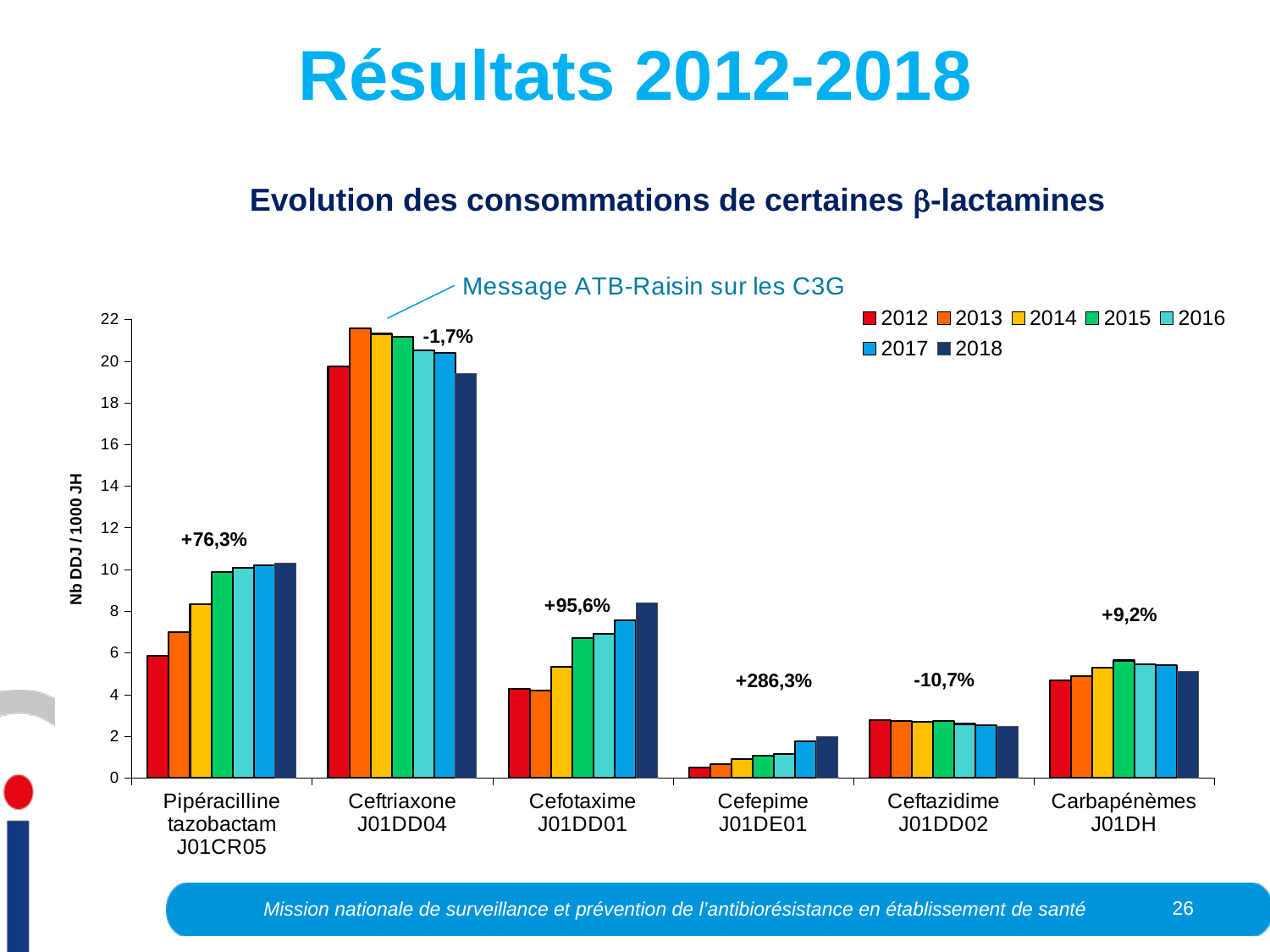
Is the 2018 value for Cefotaxime J01DD01 greater or less than 8? greater Do the values for Pipéracilline tazobactam J01CR05 rise or fall from 2012 to 2018? rise How many antibiotic categories are shown on the x axis? 6 What kind of chart is shown on the slide? bar chart Which antibiotic category has the highest consumption values? Ceftriaxone J01DD04 Is the 2013 value for Ceftriaxone J01DD04 greater or less than 20? greater Do the values for Ceftazidime J01DD02 rise or fall from 2012 to 2018? fall Is the 2012 value for Cefepime J01DE01 greater or less than 2? less Which is larger: the 2018 value for Pipéracilline tazobactam J01CR05 or the 2018 value for Cefotaxime J01DD01? Pipéracilline tazobactam J01CR05 What percentage change is printed above the Cefepime J01DE01 bars? +286,3% How many series (years) does the legend list? 7 Which antibiotic category has the lowest consumption values? Cefepime J01DE01